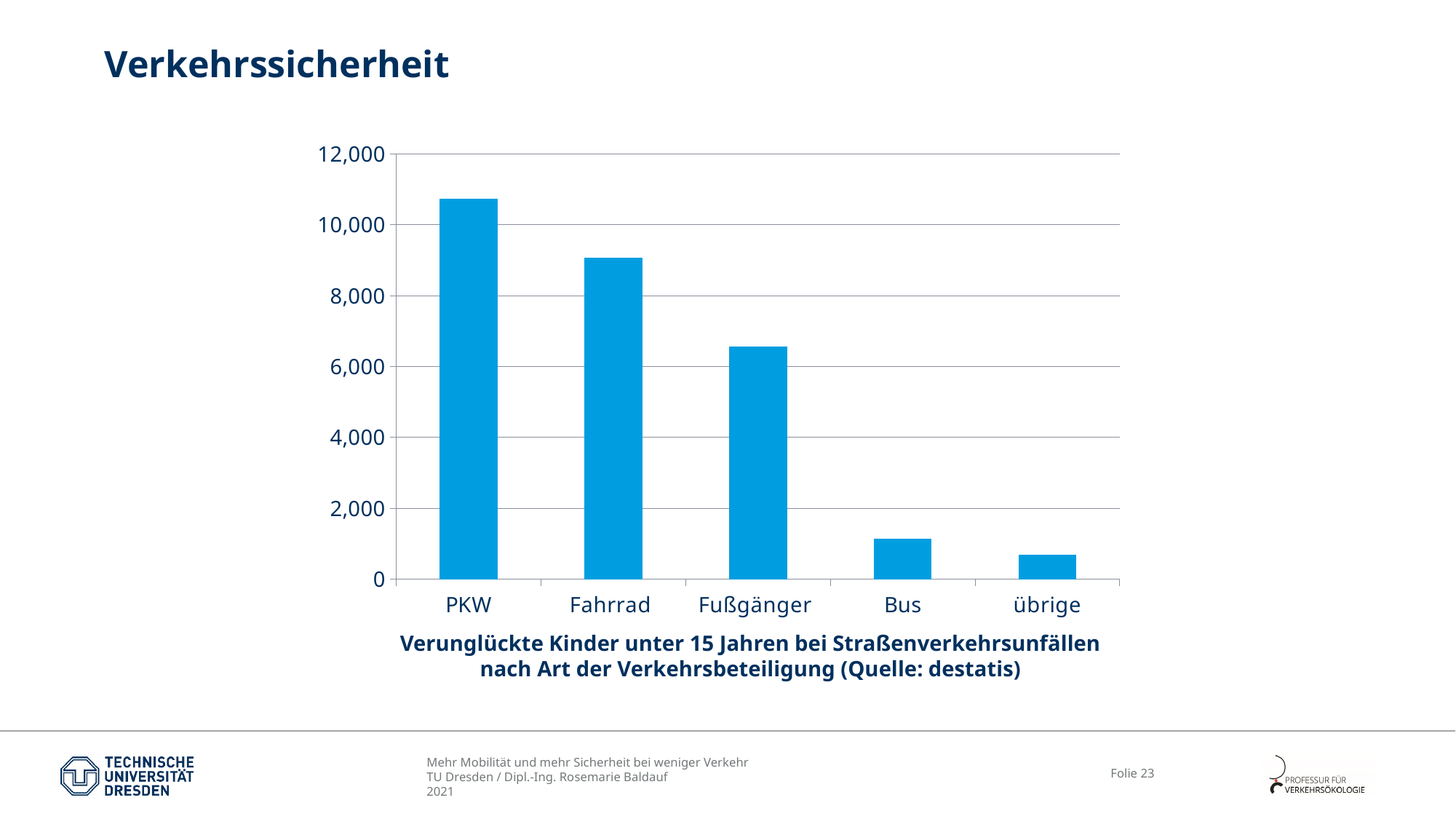
Which is larger, the value for Fahrrad or the value for Fußgänger? Fahrrad What kind of chart is shown on the slide? bar chart Is the value for PKW greater or less than 10,000? greater Is the value for Bus greater or less than 2,000? less Which category has the lowest value in the chart? übrige Which category has the highest value in the chart? PKW What is the source cited in the chart caption? destatis Do the values rise or fall from left to right along the x axis? fall How many categories are shown on the x axis of the chart? 5 Is the value for Fahrrad greater or less than 8,000? greater Which is larger, the value for Bus or the value for übrige? Bus